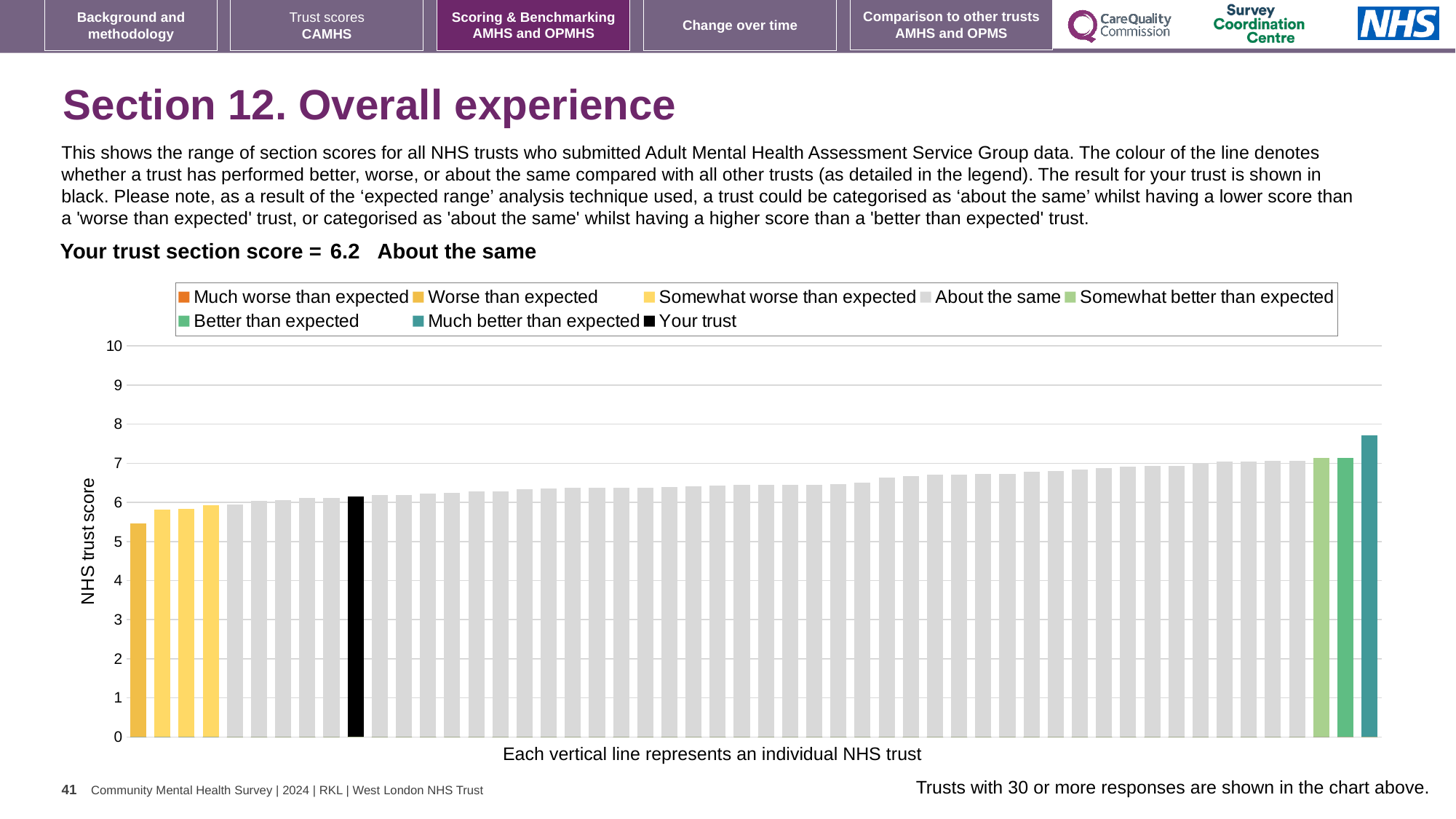
Which performance category is your trust placed in? About the same Is the value of the leftmost (lowest) bar greater or less than 6? less Do the bar values rise or fall from left to right across the chart? rise What is the section score for your trust shown on the slide? 6.2 How many bars are coloured as 'Much better than expected' (teal) in the chart? 1 Is the value of the black 'Your trust' bar greater or less than 5? greater Is the value of the tallest bar in the chart greater or less than 7? greater What is the label on the vertical axis of the chart? NHS trust score What kind of chart is shown on the slide? bar chart Which legend category does the tallest bar in the chart belong to? Much better than expected How many bars are coloured as 'Worse than expected' (yellow) in the chart? 1 How many entries does the chart legend list? 8